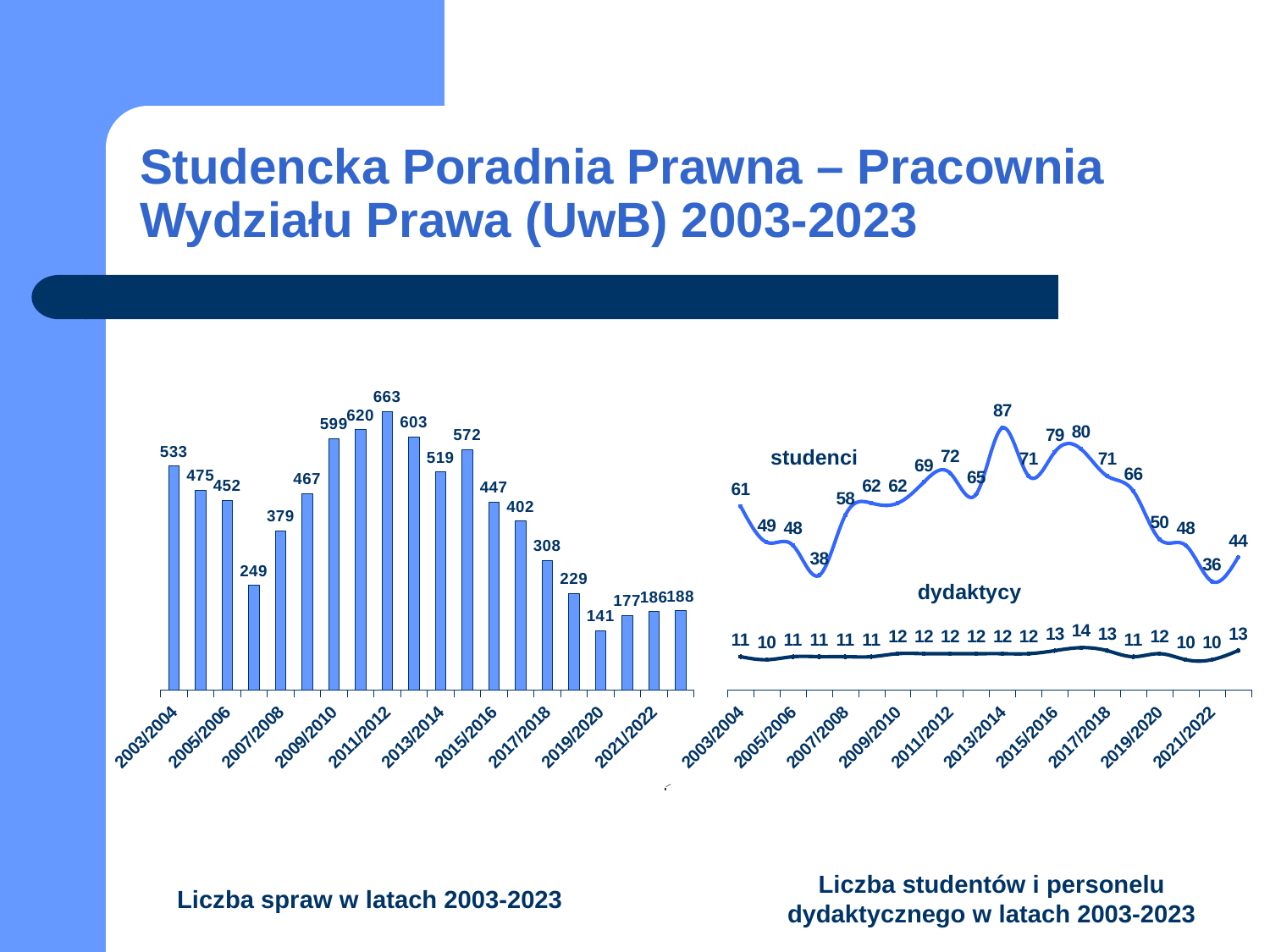
In the left chart 'Liczba spraw w latach 2003-2023', what is the value for 2003/2004? 533 In the left chart 'Liczba spraw w latach 2003-2023', what is the highest value shown? 663 How many bars are plotted in the left chart 'Liczba spraw w latach 2003-2023'? 20 How many series are plotted in the right chart 'Liczba studentów i personelu dydaktycznego w latach 2003-2023'? 2 In the left chart 'Liczba spraw w latach 2003-2023', what is the difference between the highest value (663) and the lowest value (141)? 522 What kind of chart is the right chart, 'Liczba studentów i personelu dydaktycznego w latach 2003-2023'? line chart In the right chart, what is the highest value of the 'studenci' series? 87 What kind of chart is the left chart, 'Liczba spraw w latach 2003-2023'? bar chart In the right chart, what is the highest value of the 'dydaktycy' series? 14 In the left chart 'Liczba spraw w latach 2003-2023', what is the lowest value shown? 141 In the left chart 'Liczba spraw w latach 2003-2023', what is the value for 2011/2012? 663 In the left chart 'Liczba spraw w latach 2003-2023', which is larger: the value for 2003/2004 or the value for 2005/2006? 2003/2004